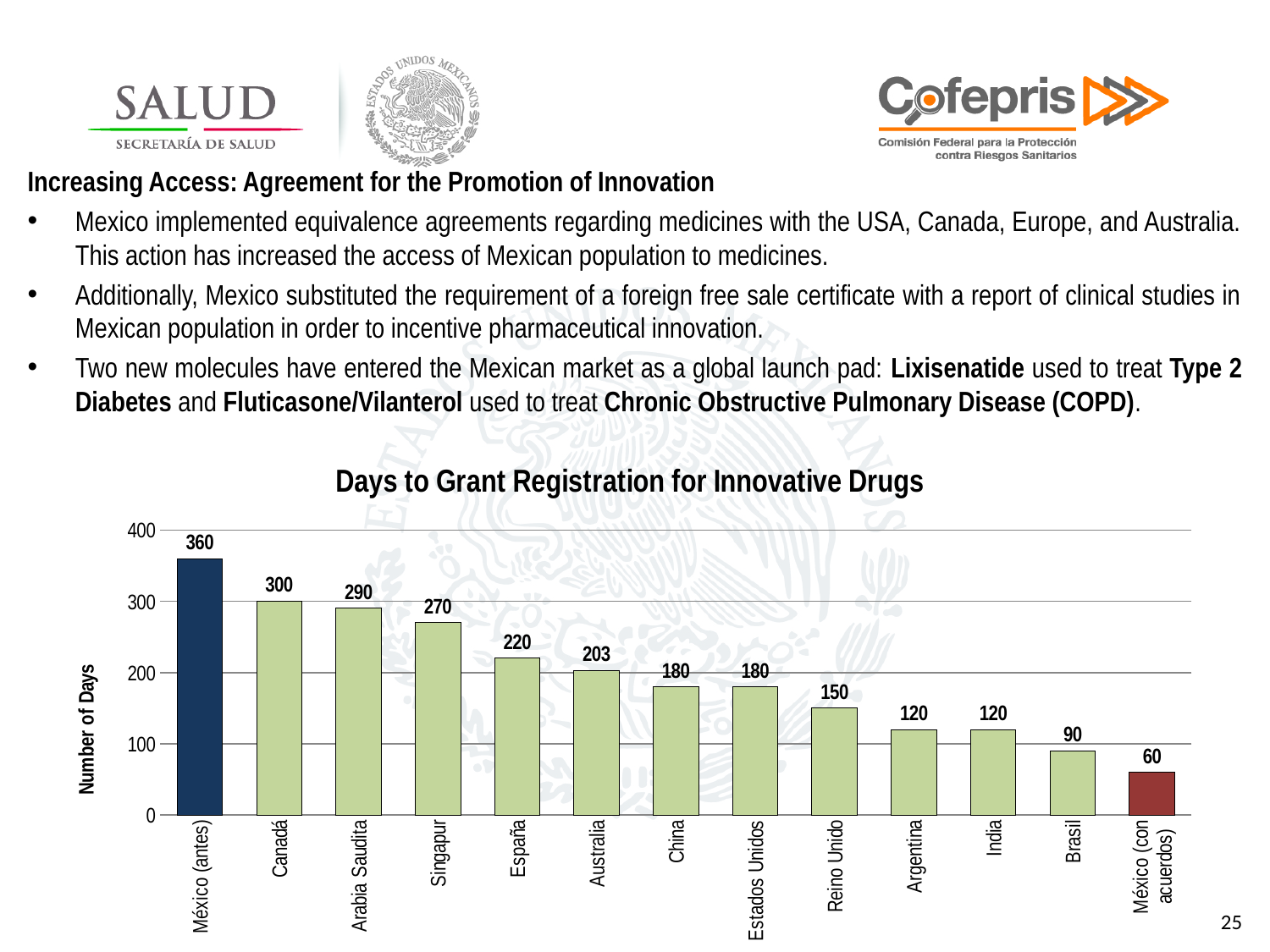
How many categories are shown on the x axis of the chart? 13 What is the difference in days between Arabia Saudita and Singapur? 20 What kind of chart is shown on the slide? Bar chart What is the title of the chart on the slide? Days to Grant Registration for Innovative Drugs Which category has the highest number of days in the chart? México (antes) What is the number of days to grant registration for innovative drugs in Canadá? 300 What is the value shown for Australia in the chart? 203 Which has more days to grant registration, España or Reino Unido? España What is the value shown for México (con acuerdos)? 60 Which category has the lowest number of days in the chart? México (con acuerdos) What is the difference in days between México (antes) and México (con acuerdos)? 300 Do the values generally rise or fall from left to right along the x axis? Fall